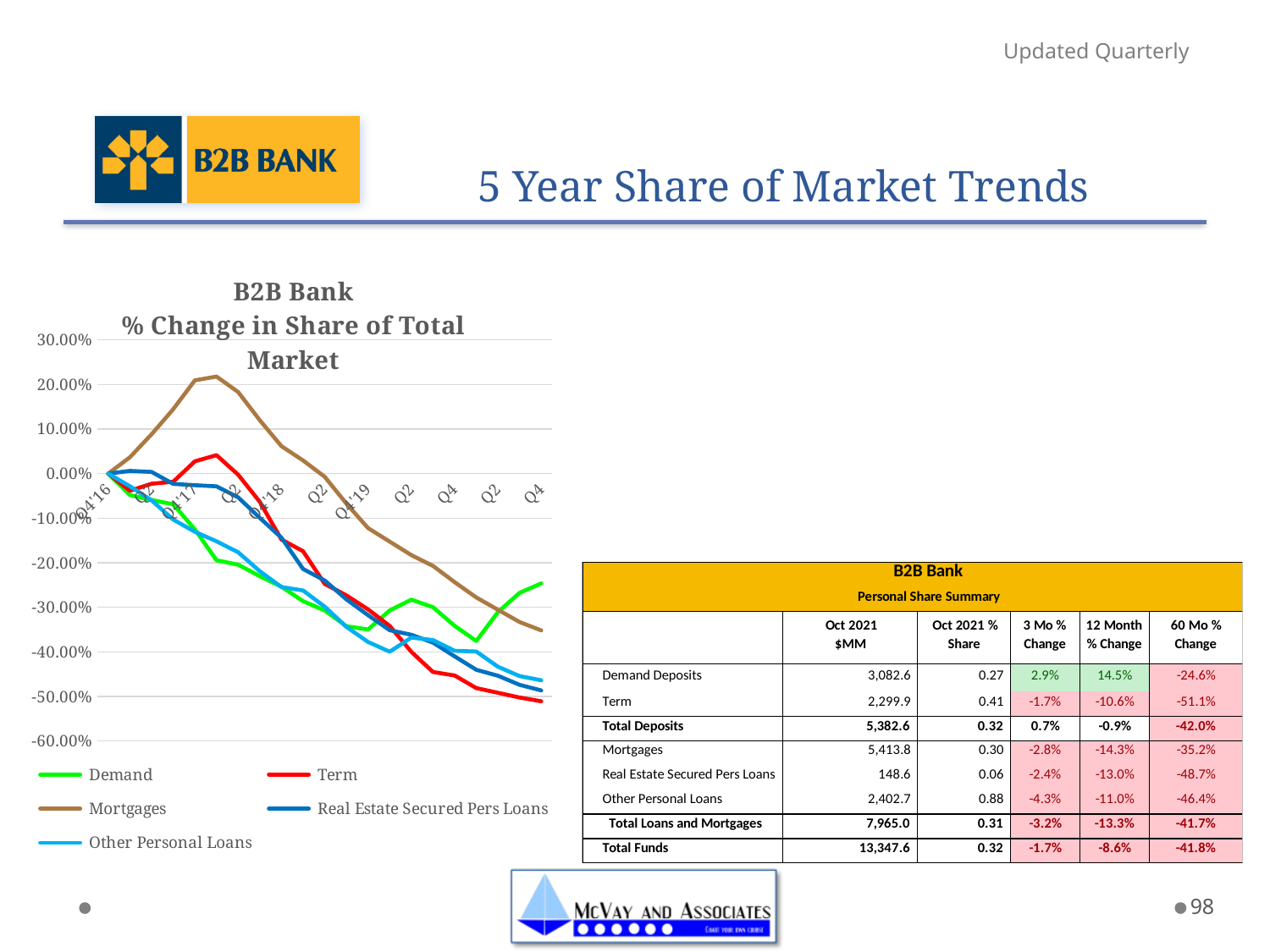
Which series is drawn in green in the chart? Demand Does the Term line overall rise or fall from Q4'16 to the final Q4 on the chart? Fall Is the value of the Term line at the final point (Q4) greater or less than -40.00%? less Is the peak value of the Mortgages line greater or less than 10.00%? greater Is the peak value of the Term line greater or less than 10.00%? less What is the title of the chart? B2B Bank % Change in Share of Total Market What kind of chart is shown on the slide? Line chart Which series reaches the highest value anywhere on the chart? Mortgages How many series does the chart legend list? 5 Which series has the highest value at the final point (Q4) on the chart? Demand Which series has the lowest value at the final point (Q4) on the chart? Term